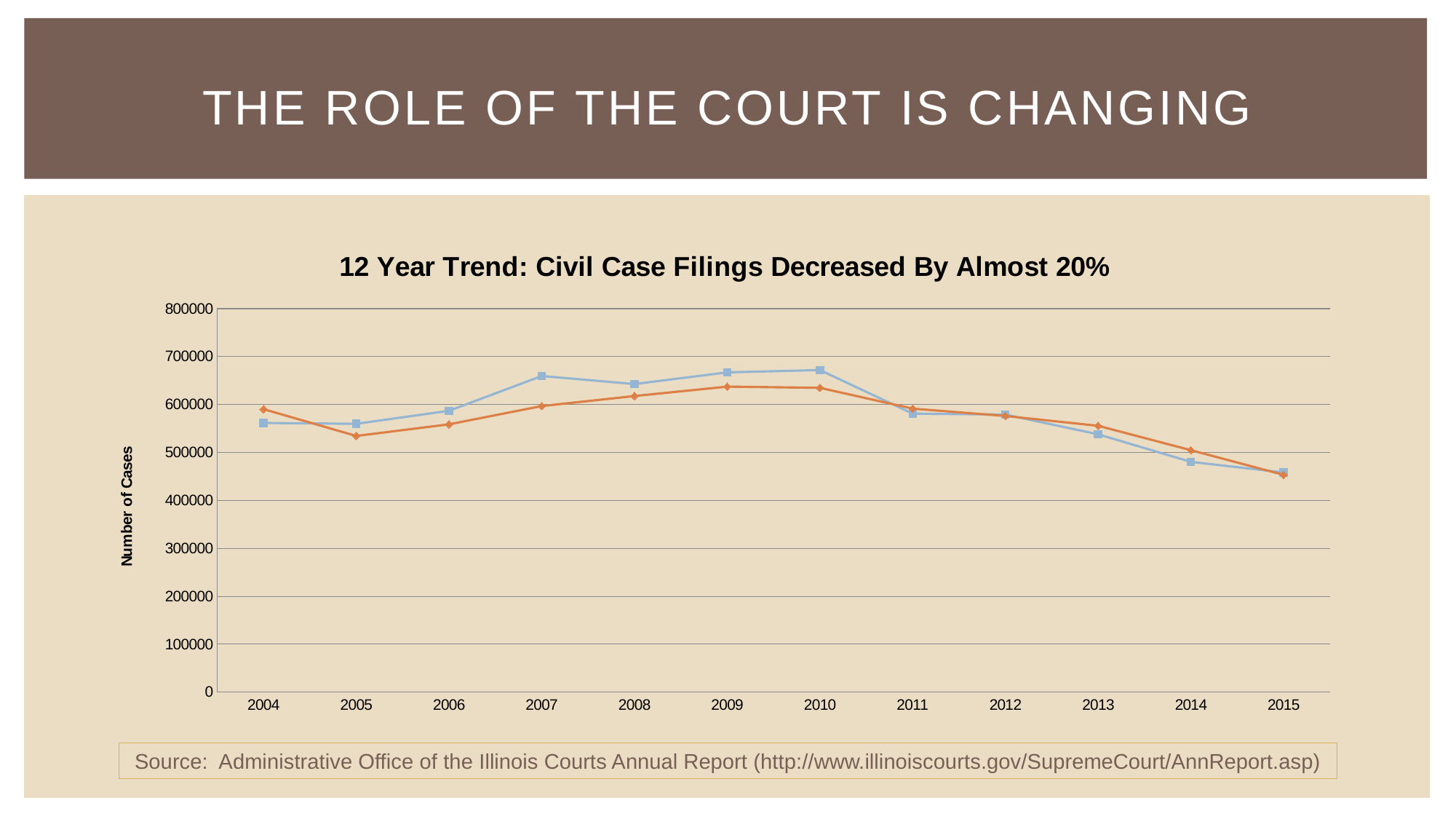
How many years are plotted along the x axis of the chart? 12 Is the value of the blue line for 2014 greater or less than 500000? less Is the value of the orange line for 2005 greater or less than 500000? greater In 2014, which line has the higher value, the blue line or the orange line? Orange line What kind of chart is shown on the slide? Line chart What is the title of the chart? 12 Year Trend: Civil Case Filings Decreased By Almost 20% Is the value of the blue line for 2010 greater or less than 600000? greater Do the values of the blue line rise or fall from 2010 to 2015? Fall In which year does the orange line reach its lowest value? 2015 What is the label on the vertical axis of the chart? Number of Cases In 2007, which line has the higher value, the blue line or the orange line? Blue line